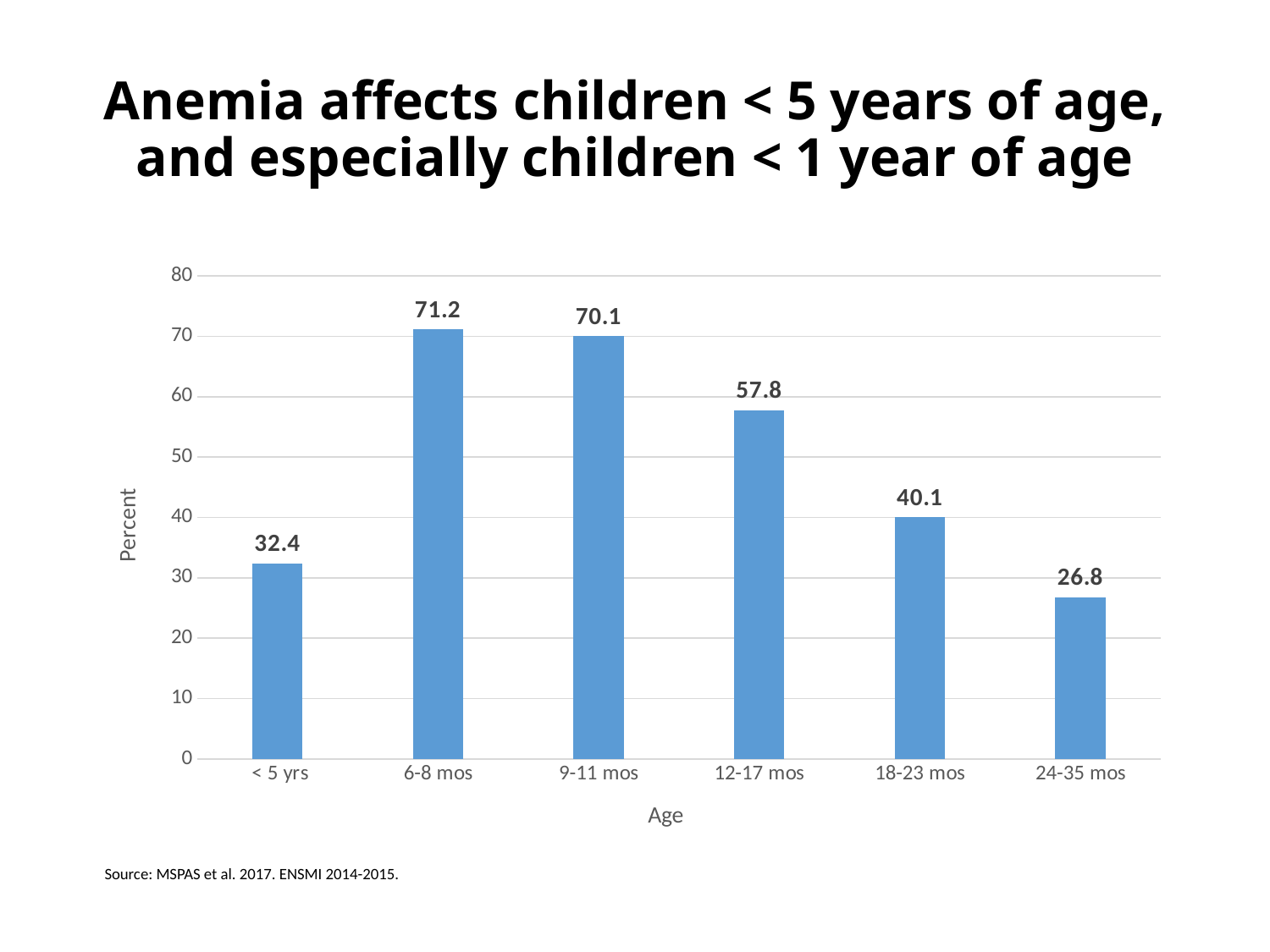
What is the label of the y axis? Percent What is the difference between the values for 12-17 mos and 18-23 mos? 17.7 Is the value for 18-23 mos greater or less than 50? less What is the value for the < 5 yrs category? 32.4 Which is larger, the value for 9-11 mos or the value for 12-17 mos? 9-11 mos Do the values rise or fall from 6-8 mos to 24-35 mos? fall How many age categories are shown on the x axis? 6 Which age group has the highest value? 6-8 mos Which age group has the lowest value? 24-35 mos What is the value for the 24-35 mos age group? 26.8 What kind of chart is shown on the slide? bar chart What is the value for the 6-8 mos age group? 71.2